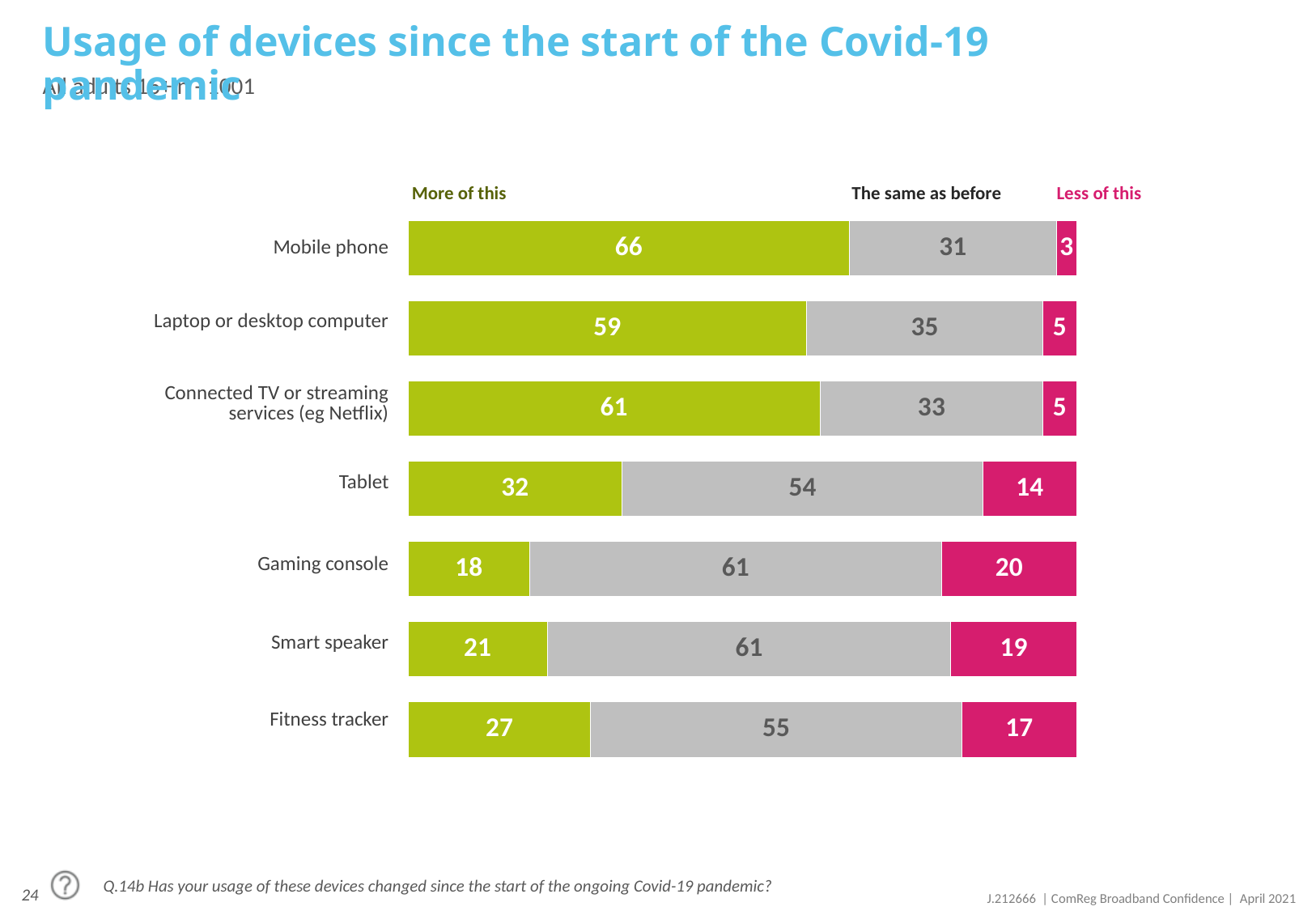
How many series does the legend list? 3 What is the difference between the 'More of this' values for Laptop or desktop computer and Tablet? 27 Which device has the highest 'More of this' value? Mobile phone Which device has the lowest 'More of this' value? Gaming console How many devices are shown in the chart? 7 What is the total of the stacked bar for Gaming console? 99 What is the 'The same as before' value for Tablet? 54 What kind of chart is shown on the slide? Stacked bar chart Which colour represents 'Less of this' in the chart? Pink What is the 'More of this' value for Mobile phone? 66 Which is larger: the 'Less of this' value for Smart speaker or for Fitness tracker? Smart speaker What is the 'Less of this' value for Gaming console? 20